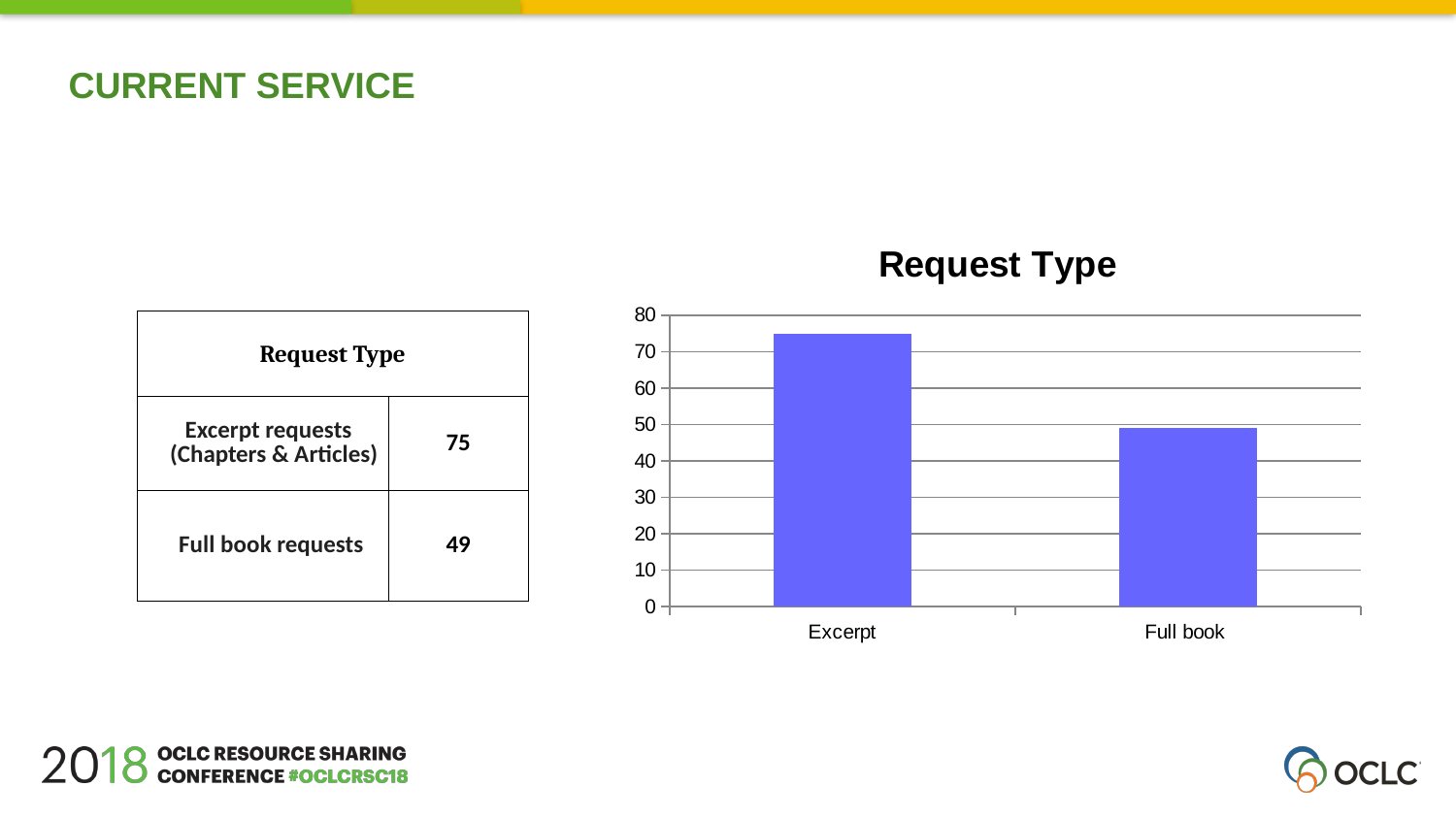
How many categories are shown on the x axis of the chart? 2 What is the difference between the Excerpt requests and the Full book requests shown on the slide? 26 What is the title of the chart? Request Type What type of chart is shown on the slide? bar chart Which is larger, the value for Excerpt or the value for Full book? Excerpt Which category has the lowest value in the chart? Full book According to the slide, what is the number of Excerpt requests? 75 Is the value for Excerpt greater or less than 70? greater Which category has the highest value in the chart? Excerpt What is the maximum value shown on the chart's vertical axis? 80 Is the value for Full book greater or less than 50? less According to the slide, what is the number of Full book requests? 49